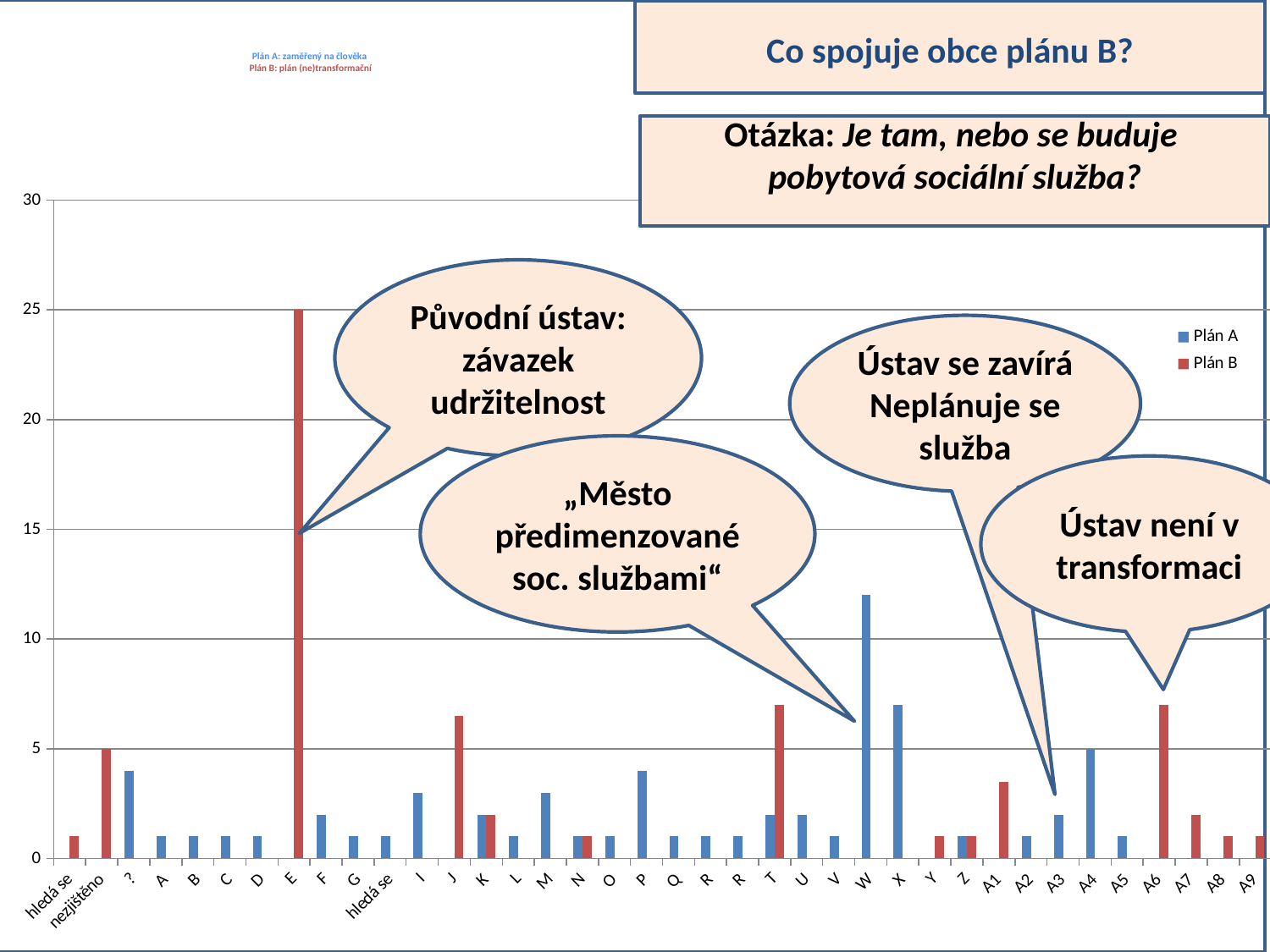
What is the Plán A value for category A4? 5 Which is larger, the Plán A value for W or the Plán A value for X? W Which category has the highest Plán A value? W What type of chart is shown on the slide? bar chart How many series does the chart legend list? 2 What colour are the Plán B bars? red Is the Plán A value for W greater or less than 10? greater What are the two series named in the legend? Plán A and Plán B Is the Plán B value for T greater or less than 5? greater What is the Plán B value for category nezjištěno? 5 Which category has the highest Plán B value? E What is the Plán B value for category E? 25